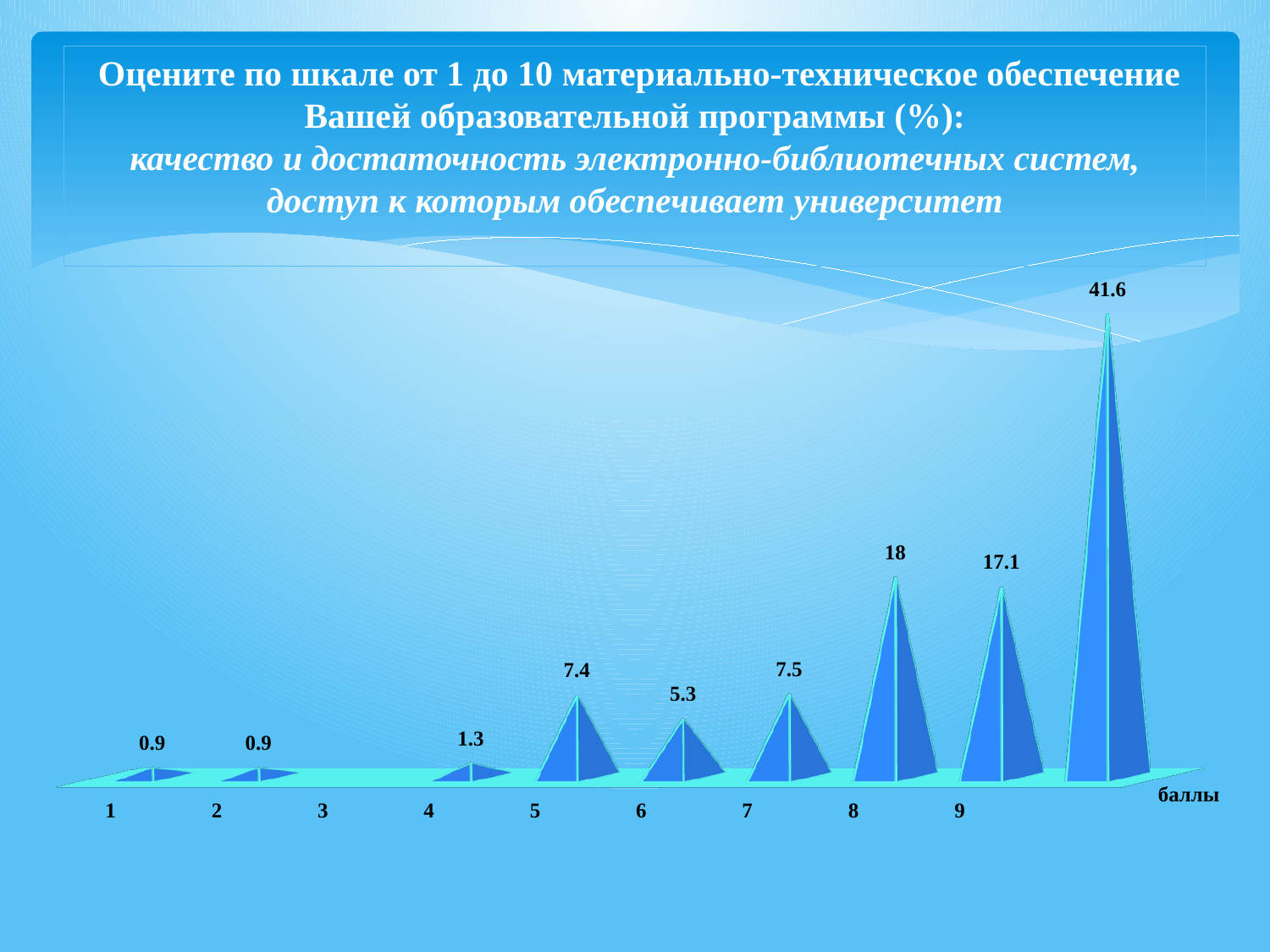
Which has the larger value, score 8 or score 9? 8 What is the value for score 8? 18 What is the highest value shown on the chart? 41.6 What is the label of the horizontal axis? баллы What kind of chart is shown on the slide? bar chart What is the difference between the values for score 8 and score 9? 0.9 What is the value for score 9? 17.1 What is the lowest data label value shown on the chart? 0.9 Which has the larger value, score 5 or score 6? 5 What is the difference between the values for score 7 and score 6? 2.2 What is the value for score 5? 7.4 What is the value for score 4? 1.3